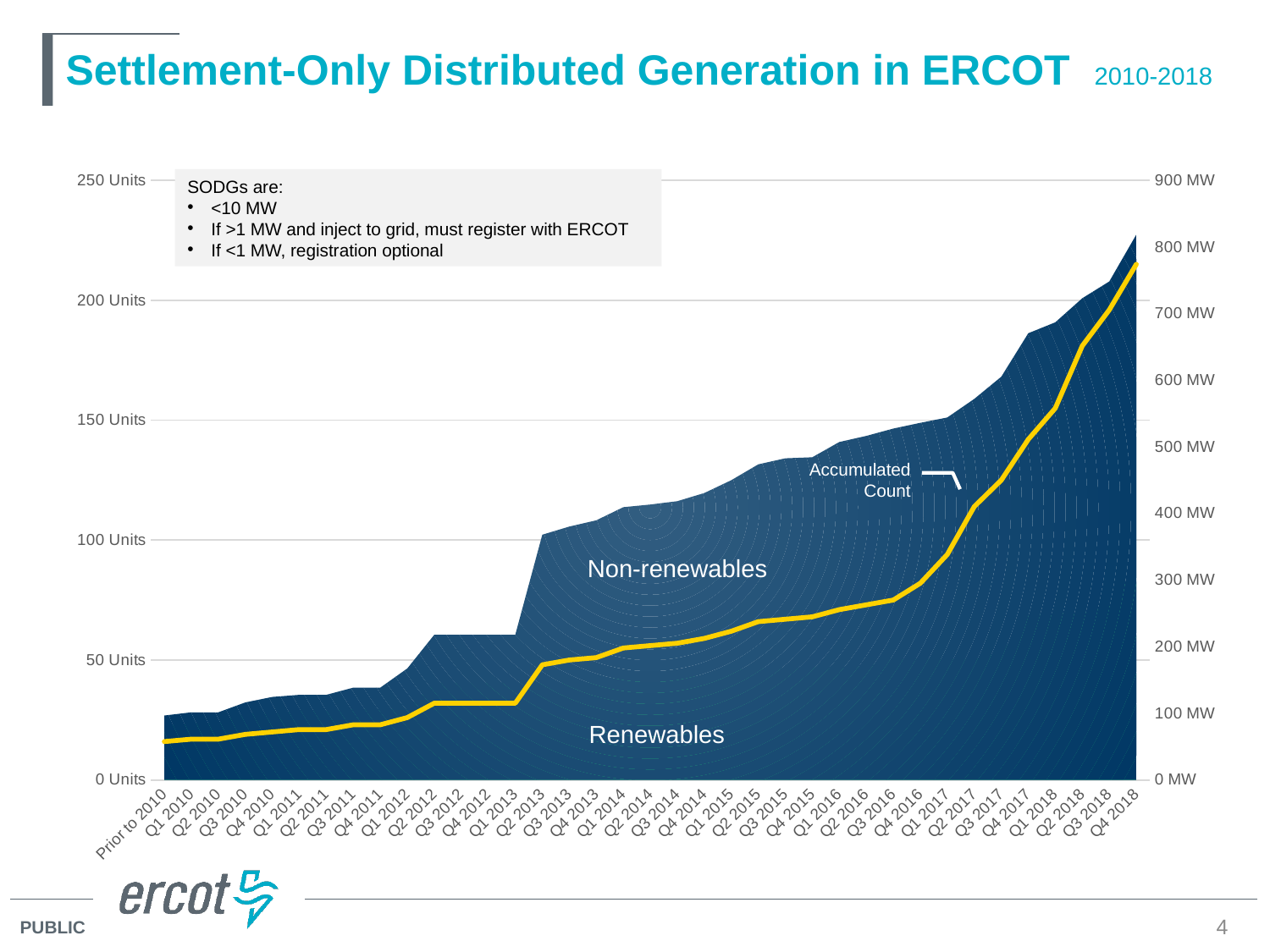
Which period has the highest Accumulated Count? Q4 2018 Which period has the lowest Accumulated Count? Prior to 2010 Is the Accumulated Count at Q1 2010 greater or less than 50 Units? less Is the Accumulated Count larger in Q4 2018 or in Q1 2014? Q4 2018 Does the Accumulated Count line rise or fall from left to right along the x axis? Rise What does the yellow line in the chart represent? Accumulated Count What is the title of the chart on the slide? Settlement-Only Distributed Generation in ERCOT 2010-2018 What are the two labelled areas in the chart? Non-renewables and Renewables How many time periods are shown along the x axis? 37 What kind of chart is shown on the slide? Area chart with a line overlay Is the Accumulated Count at Q4 2016 greater or less than 100 Units? less Is the Accumulated Count at Q4 2018 greater or less than 200 Units? greater